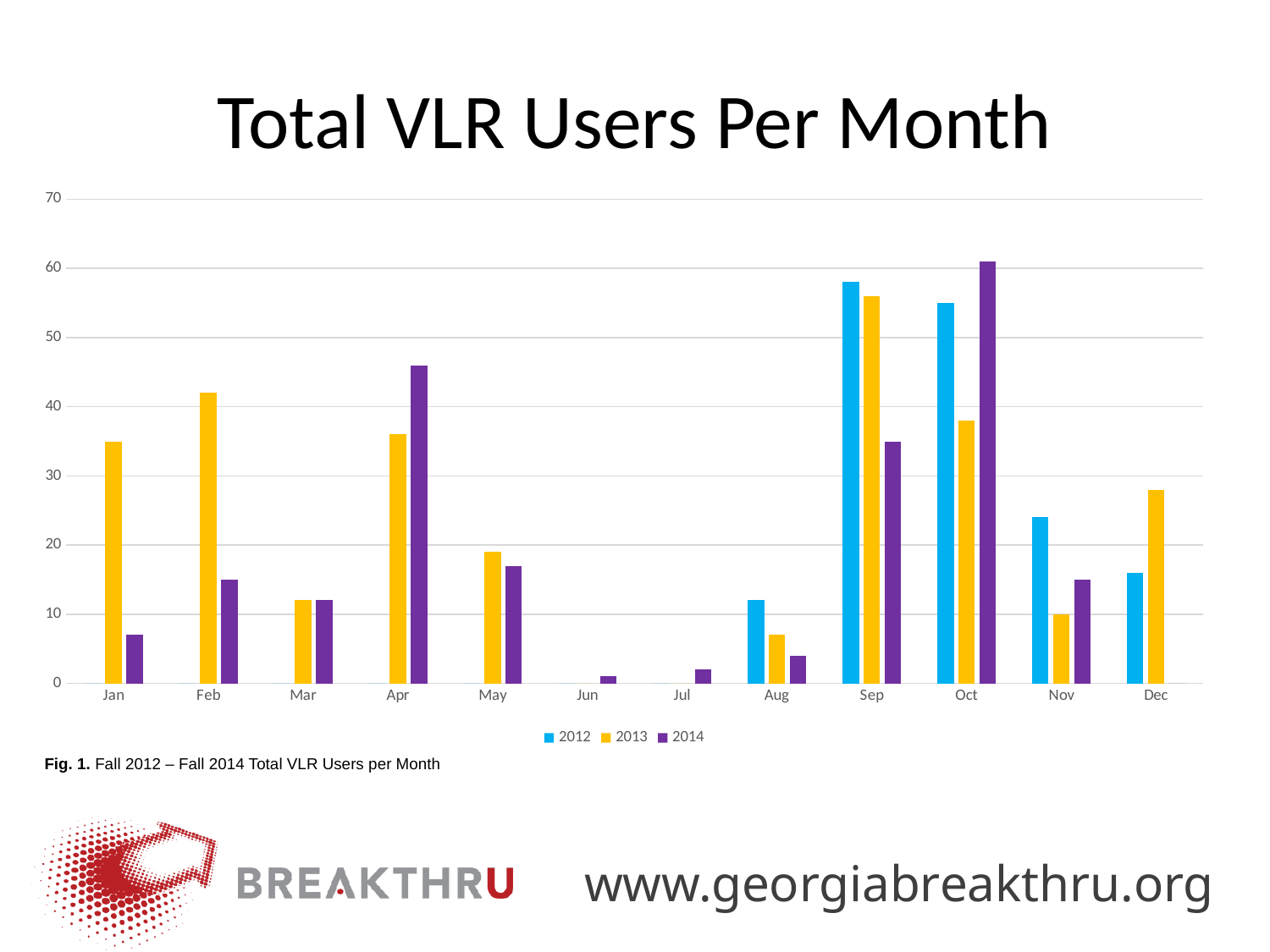
Is the 2013 value for Feb greater or less than 30? greater In which month is the 2014 value highest? Oct What is the title of the chart? Total VLR Users Per Month Do the 2013 values rise or fall from Sep to Nov? fall How many series does the legend list? 3 In November, which is larger: the 2012 value or the 2014 value? 2012 Is the 2012 value for Sep greater or less than 50? greater In which month is the 2013 value highest? Sep In April, which is larger: the 2013 value or the 2014 value? 2014 What kind of chart is shown on the slide? bar chart How many months are shown along the x axis? 12 Is the 2014 value for Jan greater or less than 10? less